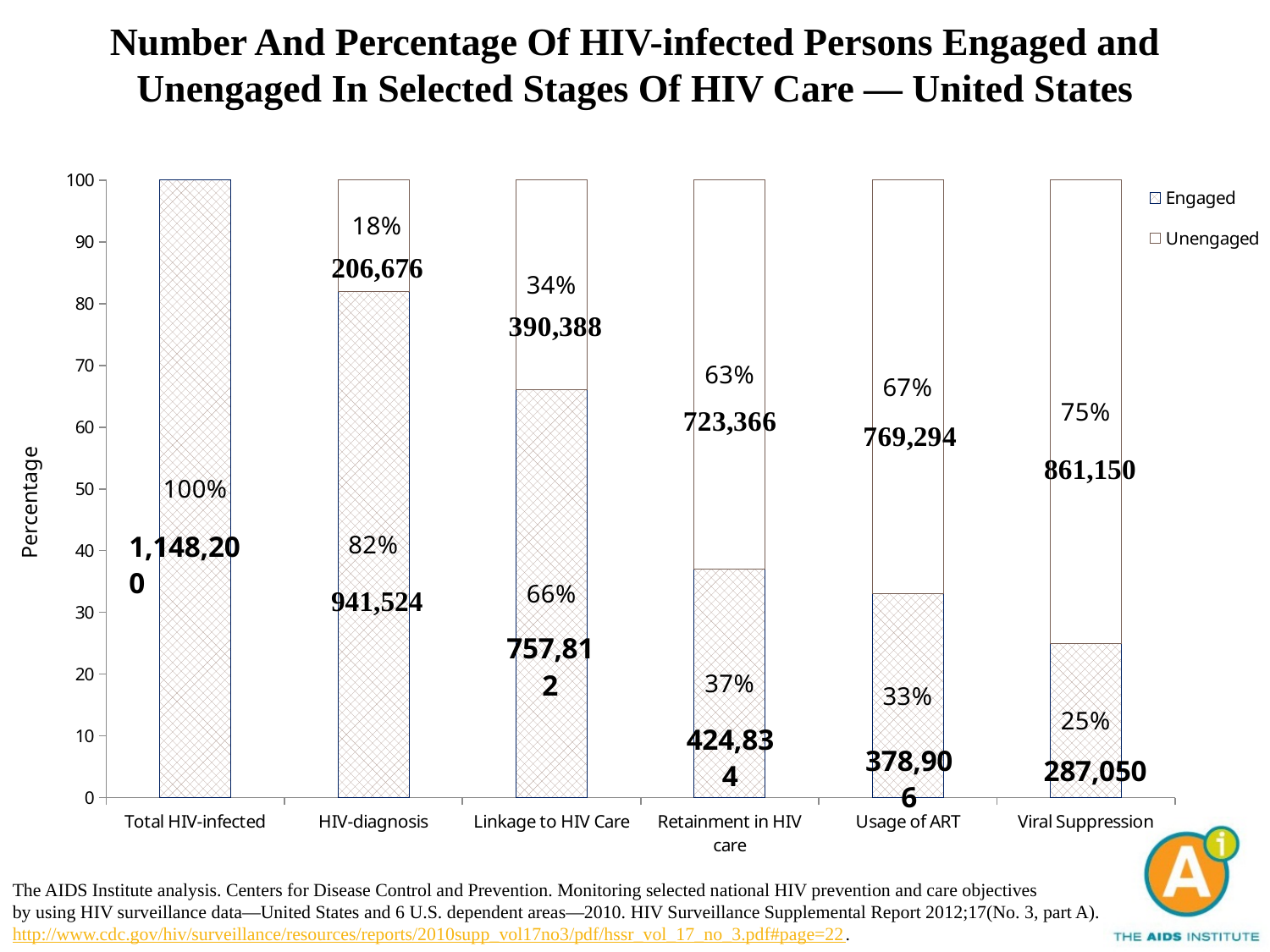
What percentage of persons are Engaged in the Viral Suppression stage? 25% How many series does the chart's legend list? 2 Which stage has the highest Unengaged percentage? Viral Suppression What type of chart is shown on the slide? Stacked bar chart What is the number of persons Engaged in the Usage of ART stage? 378,906 What is the difference in Engaged percentage between HIV-diagnosis and Linkage to HIV Care? 16% Which stage has the lowest Engaged percentage? Viral Suppression What percentage of persons are Unengaged in the Retainment in HIV care stage? 63% What is the number of persons Unengaged in the HIV-diagnosis stage? 206,676 How many categories are shown on the x axis of the chart? 6 Is the Engaged percentage larger for Retainment in HIV care or for Usage of ART? Retainment in HIV care Does the Engaged percentage rise or fall moving from Total HIV-infected to Viral Suppression along the x axis? Fall